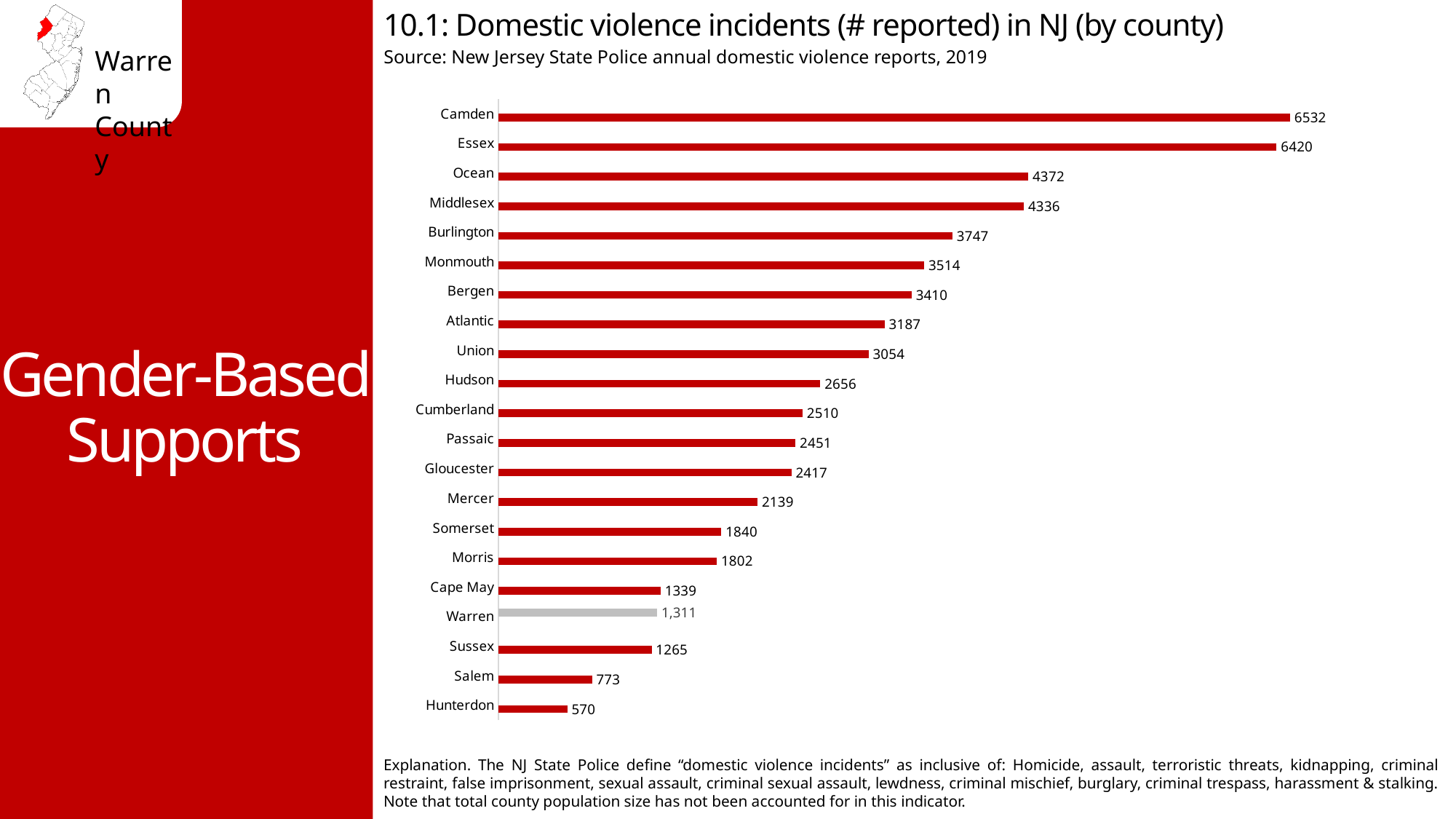
What is the difference between the values for Warren and Sussex? 46 What is the difference between the values for Camden and Essex? 112 Which has more reported incidents, Ocean or Bergen? Ocean Which county has the lowest number of reported domestic violence incidents? Hunterdon How many counties are shown in the chart? 21 What is the value shown for Monmouth? 3514 What type of chart is used on this slide? Bar chart What is the number of reported domestic violence incidents for Warren County? 1,311 What is the number of reported domestic violence incidents for Camden? 6532 Which has fewer reported incidents, Salem or Cape May? Salem Which county has the highest number of reported domestic violence incidents? Camden Which county's bar is coloured grey instead of red? Warren